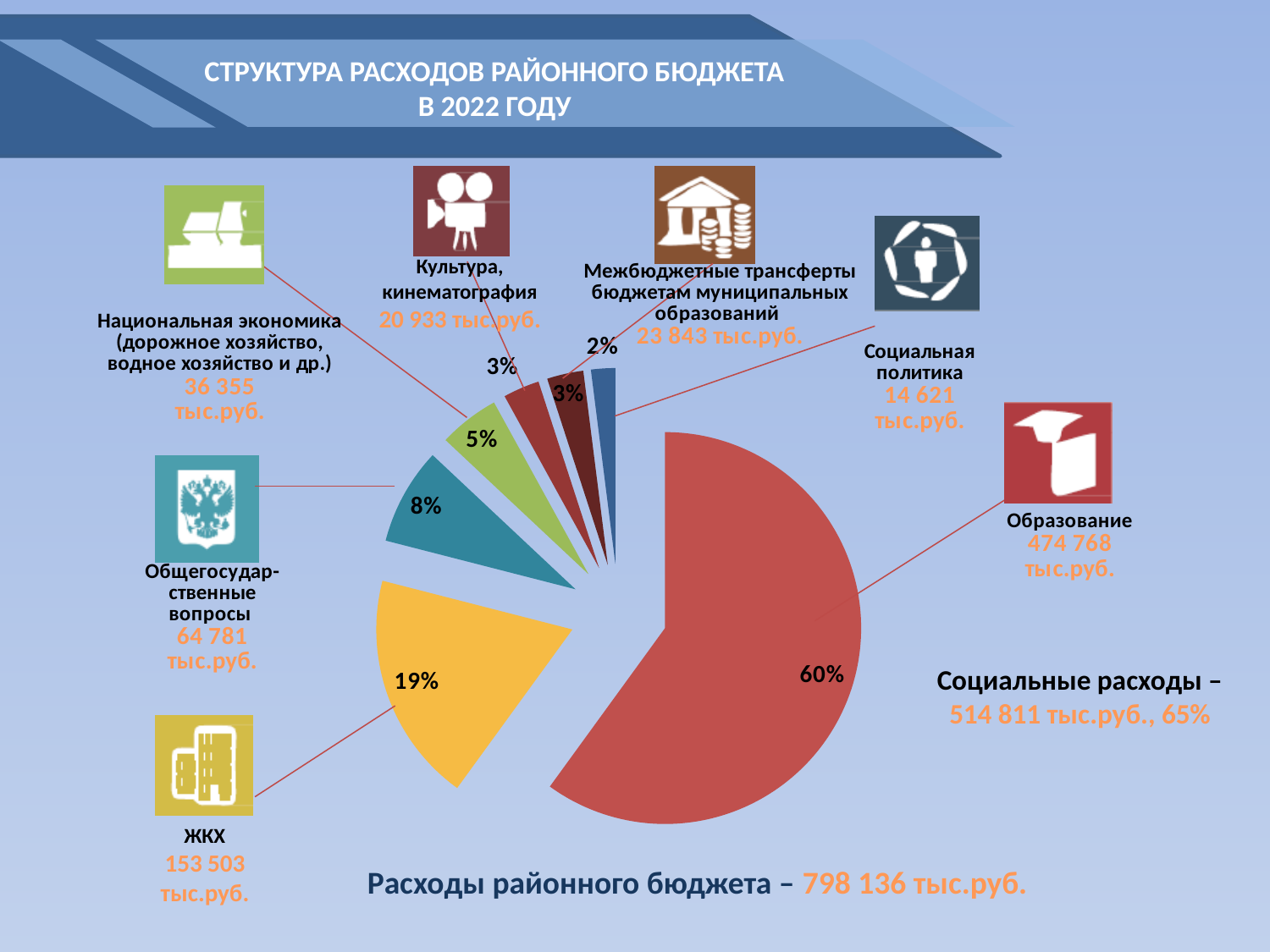
Which is larger, the value for ЖКХ or the value for Общегосударственные вопросы? ЖКХ What is the value shown for Общегосударственные вопросы? 64 781 тыс.руб. What is the value shown for Социальная политика? 14 621 тыс.руб. What total district budget expenditure is stated on the slide? 798 136 тыс.руб. What is the value shown for Национальная экономика? 36 355 тыс.руб. Which category has the largest slice of the pie? Образование What is the difference between the values for Межбюджетные трансферты and Культура, кинематография? 2 910 тыс.руб. Which category has the smallest slice of the pie? Социальная политика What share of the pie does Образование (education) take? 60% What share of the pie does ЖКХ take? 19% How many slices does the pie chart have? 7 What kind of chart is shown on the slide? pie chart